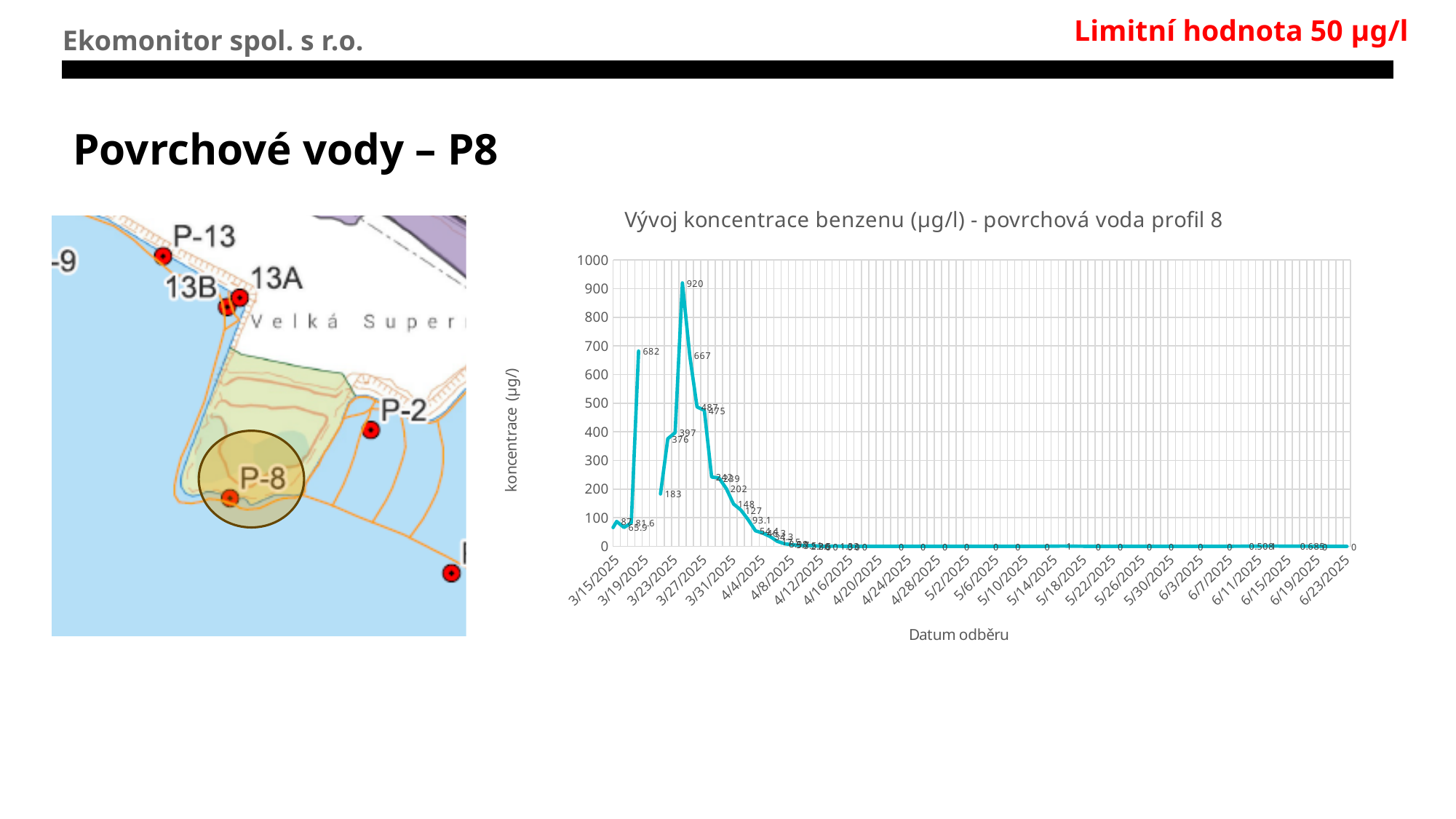
What kind of chart is shown on the slide? line chart What is the label of the vertical axis? koncentrace (µg/l) Which is larger, the labelled value 682 or the labelled value 667? 682 What is the difference between the peak value of 920 and the earlier peak of 682? 238 Is the peak value of the line greater or less than 900? greater How many data series are plotted on the chart? 1 After the peak at 920, do the values rise or fall over the following dates? fall What is the difference between the labelled values 487 and 475? 12 What is the maximum value shown on the vertical axis? 1000 What is the lowest value labelled on the chart? 0 What is the title of the chart? Vývoj koncentrace benzenu (µg/l) - povrchová voda profil 8 What is the highest benzene concentration value labelled on the chart? 920